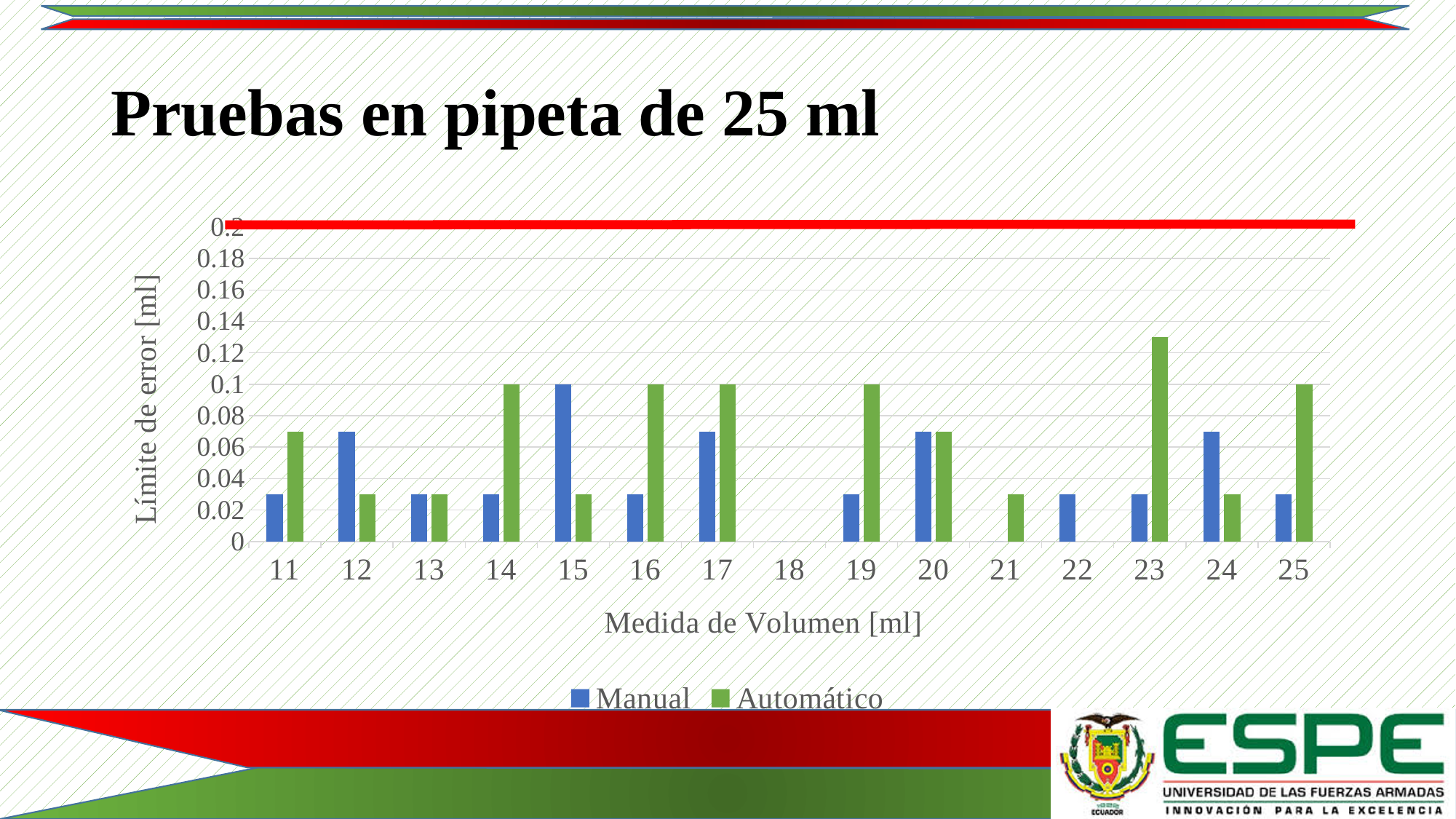
At 16 ml, which series has the larger error, Manual or Automático? Automático How many series does the legend list? 2 At 12 ml, which series has the larger error, Manual or Automático? Manual What kind of chart is shown on the slide? bar chart Is the Automático value at 23 ml greater or less than 0.12? greater How many volume measurement categories are shown on the x axis? 15 What is the Manual error value at 15 ml? 0.1 At which volume measurement is the Automático error highest? 23 Is the Manual value at 11 ml greater or less than 0.04? less What is the title of the y axis? Límite de error [ml] At which volume measurement is the Manual error highest? 15 What is the Automático error value at 14 ml? 0.1